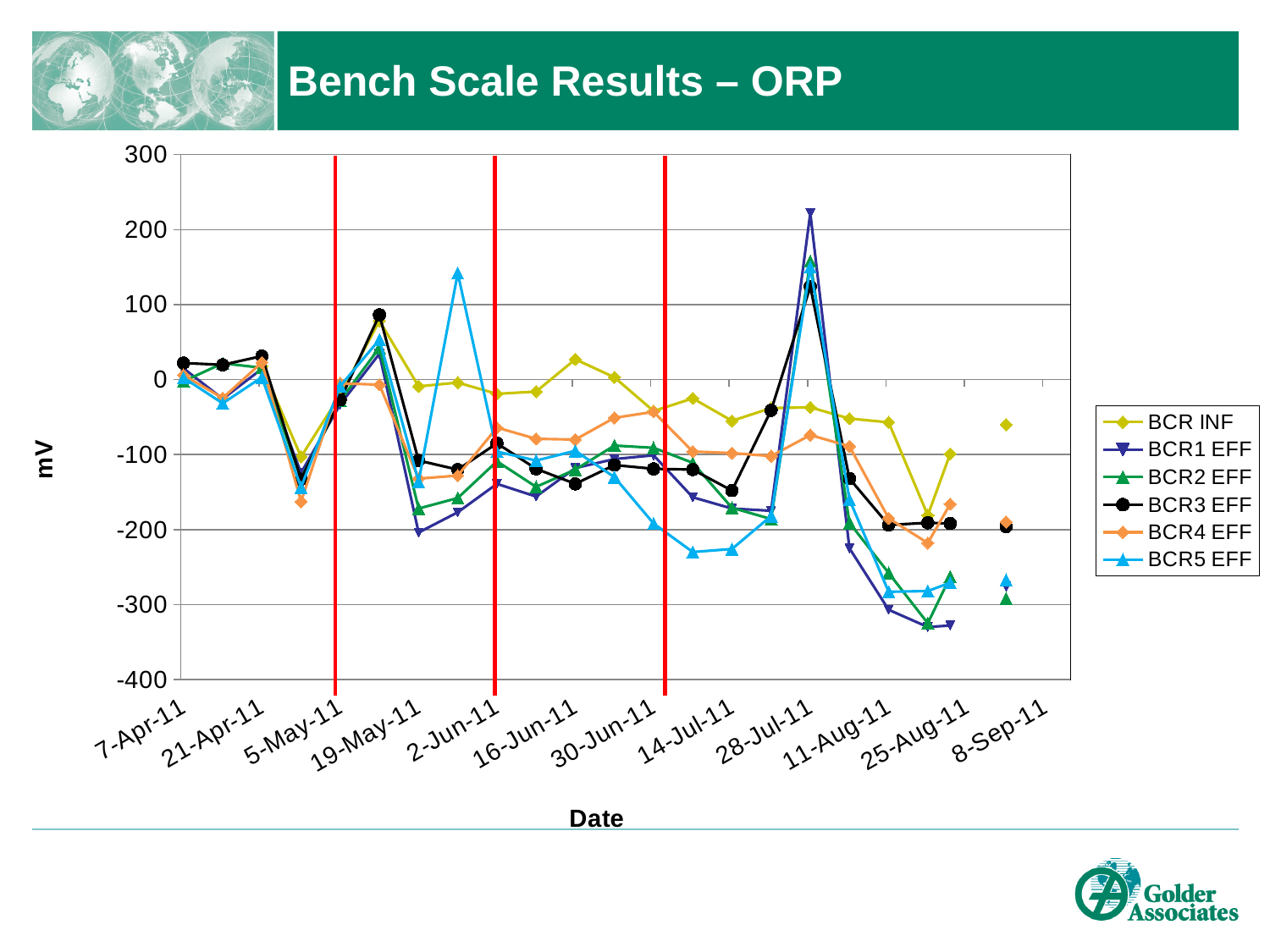
What unit is shown on the vertical axis label? mV Is the value for BCR5 EFF at 2-Jun-11 greater or less than 100? less Is the value for BCR1 EFF at 25-Aug-11 greater or less than -300? less What kind of chart is shown on the slide? line chart Is the value for BCR4 EFF at 5-May-11 greater or less than -100? greater What is the title of the chart? Bench Scale Results – ORP How many series does the legend list? 6 Which series has the lowest value around 25-Aug-11? BCR1 EFF Does the BCR INF series rise or fall between 28-Jul-11 and 25-Aug-11? fall Which series has the highest value at the last date, 8-Sep-11? BCR INF Which series has the highest value at the 28-Jul-11 peak? BCR1 EFF